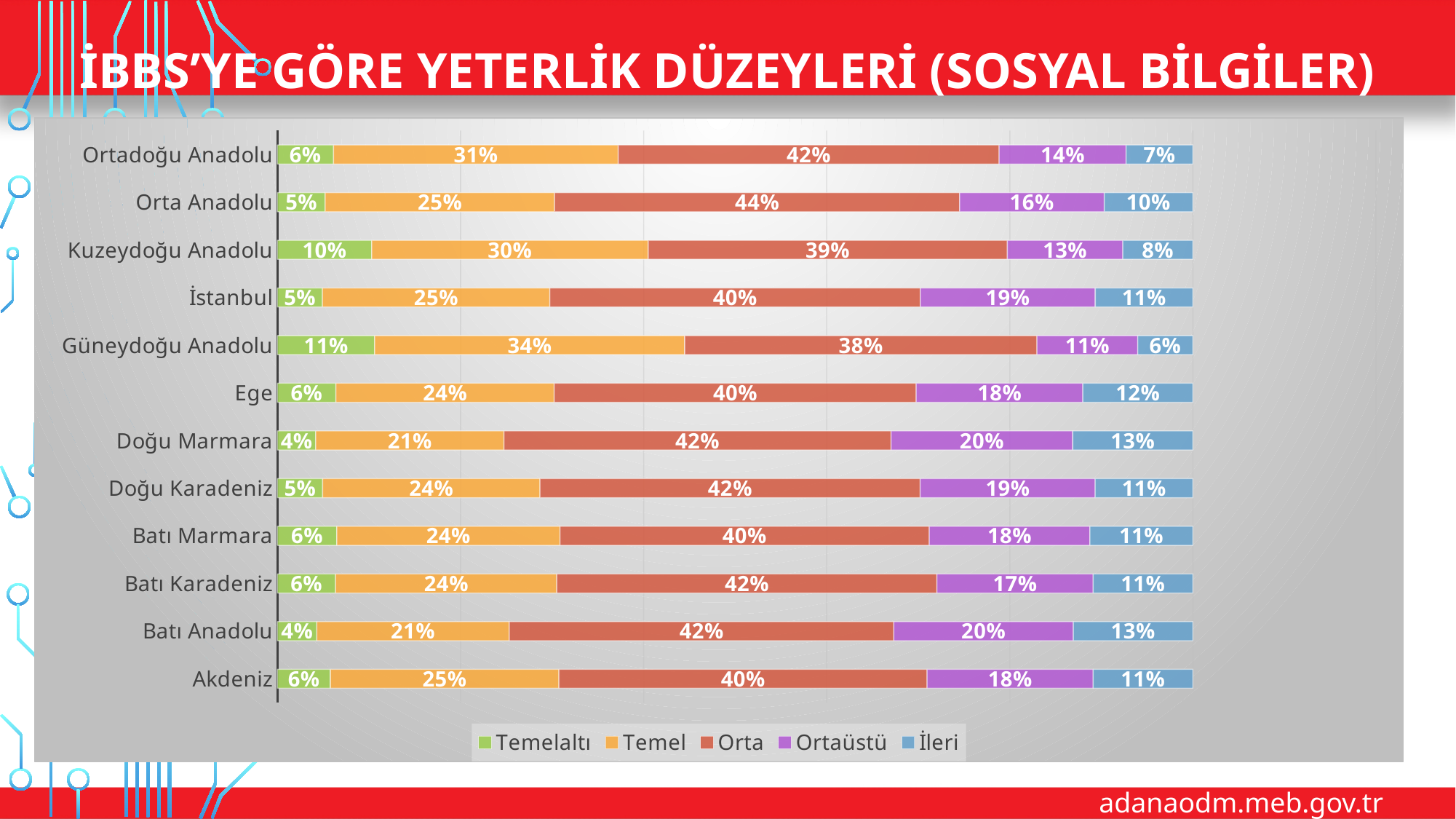
What is the İleri value for Ege? 12% What is the Ortaüstü value for Kuzeydoğu Anadolu? 13% What is the total of the labelled segments for the Doğu Karadeniz bar? 101% Which region has the lowest İleri value? Güneydoğu Anadolu How many regions are shown on the chart? 12 How many series does the legend list? 5 Which is larger, the Ortaüstü value for İstanbul or for Ortadoğu Anadolu? İstanbul What is the Orta value for Orta Anadolu? 44% What kind of chart is shown on the slide? Stacked bar chart What is the Temel value for Güneydoğu Anadolu? 34% What is the difference between the Orta values for Orta Anadolu and Güneydoğu Anadolu? 6% Which region has the highest Temelaltı value? Güneydoğu Anadolu